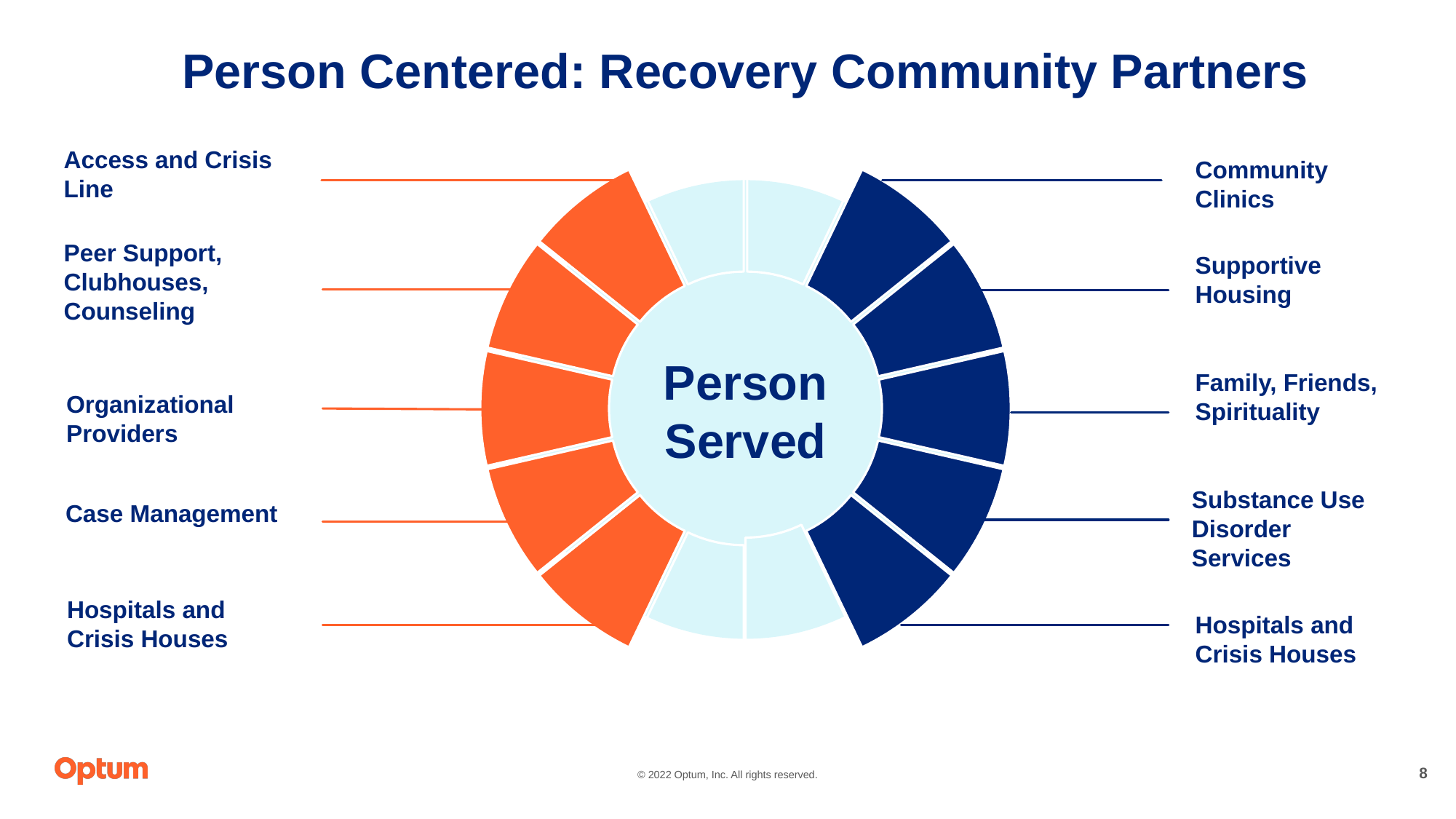
What is the title of the slide containing the circular diagram? Person Centered: Recovery Community Partners How many orange segments are in the circular diagram? 5 What text appears in the center of the circular diagram? Person Served Which label appears on both the left and right sides of the diagram? Hospitals and Crisis Houses What colour are the segments connected to the labels on the left side of the diagram? Orange How many dark blue segments are in the circular diagram? 5 How many labeled partner categories surround the circular diagram in total? 10